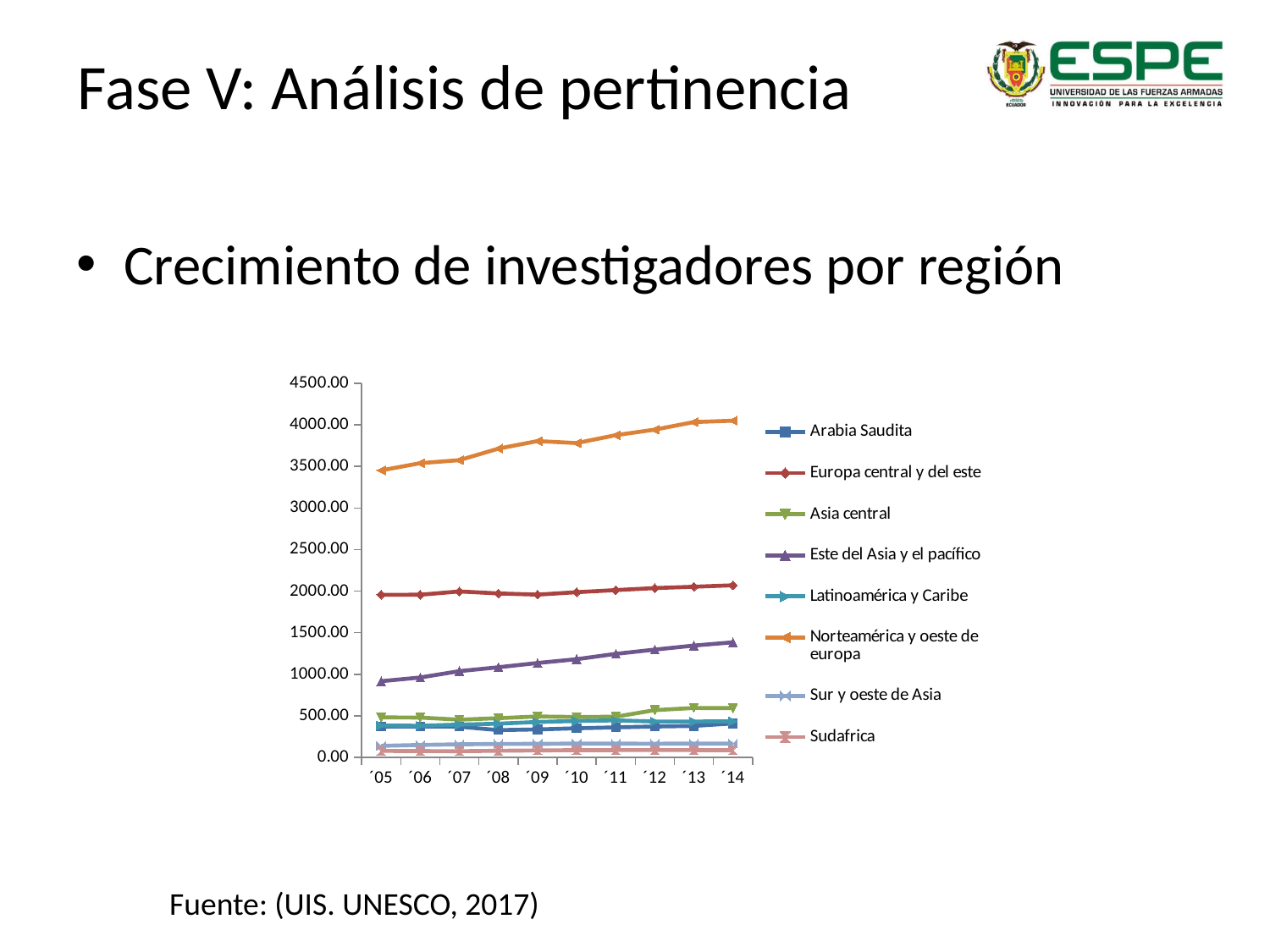
In ´14, which is larger: Europa central y del este or Este del Asia y el pacífico? Europa central y del este How many years are plotted along the x axis? 10 How many series does the legend list? 8 What kind of chart is shown on the slide? Line chart Which region has the highest values across the whole chart? Norteamérica y oeste de europa Does the line for Norteamérica y oeste de europa rise or fall from ´05 to ´14? Rises Is the value for Norteamérica y oeste de europa in ´05 greater or less than 3000.00? greater Does the line for Este del Asia y el pacífico rise or fall from ´05 to ´14? Rises What is the first year shown on the x axis? ´05 Is the value for Este del Asia y el pacífico in ´14 greater or less than 1000.00? greater Is the value for Europa central y del este in ´14 greater or less than 2500.00? less Which region has the lowest values across the whole chart? Sudafrica